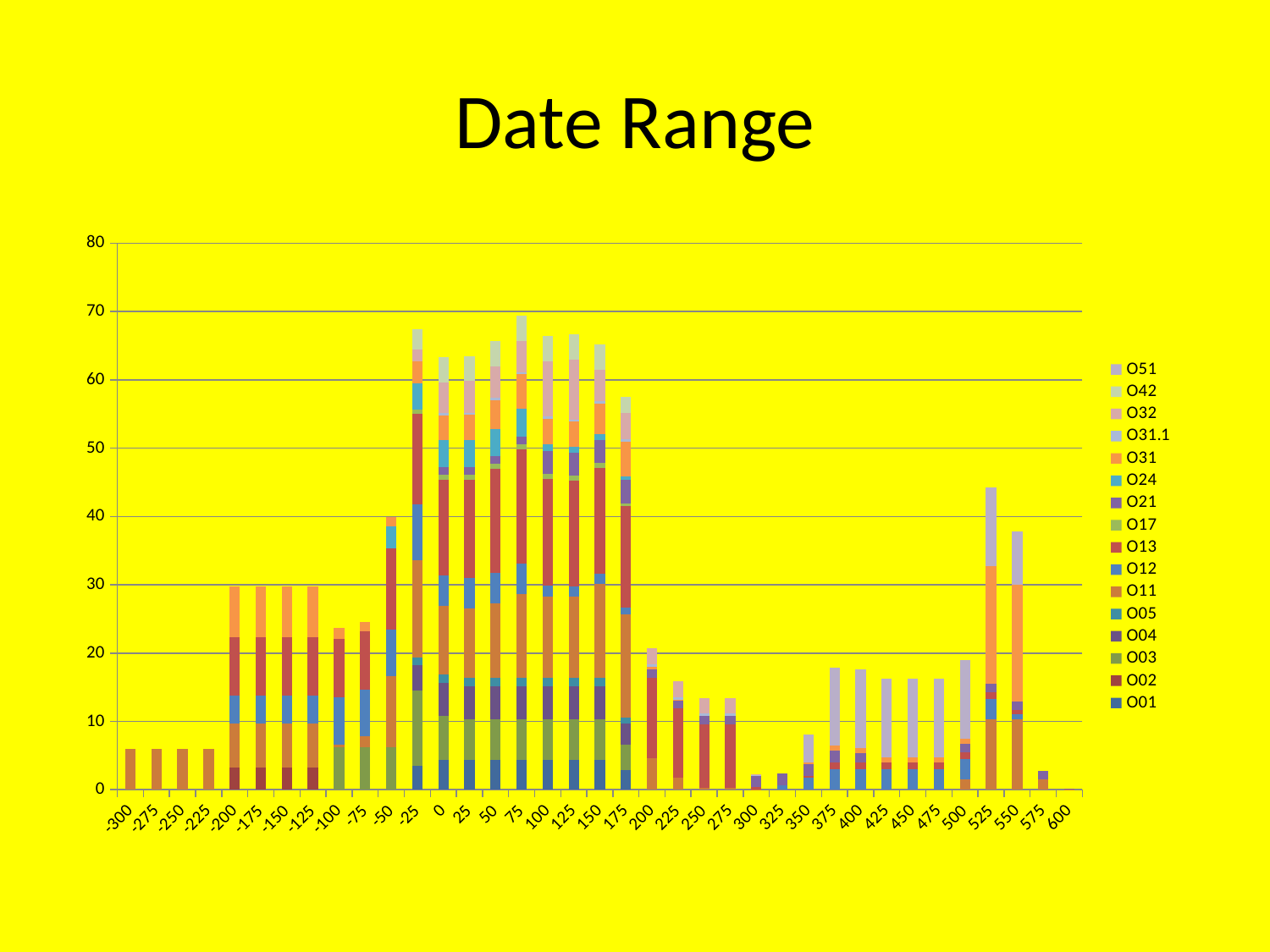
Is the total value of the bar at 225 greater or less than 20? less How many series does the legend list? 16 Which bar is taller, the one at 525 or the one at 550? 525 Is the total value of the bar at 75 greater or less than 60? greater Which series is listed first in the legend? O51 What is the title of the chart? Date Range Which bar is taller, the one at -200 or the one at -300? -200 Is the total value of the bar at 525 greater or less than 40? greater What kind of chart is shown on the slide? stacked bar chart How many categories are shown along the x axis? 37